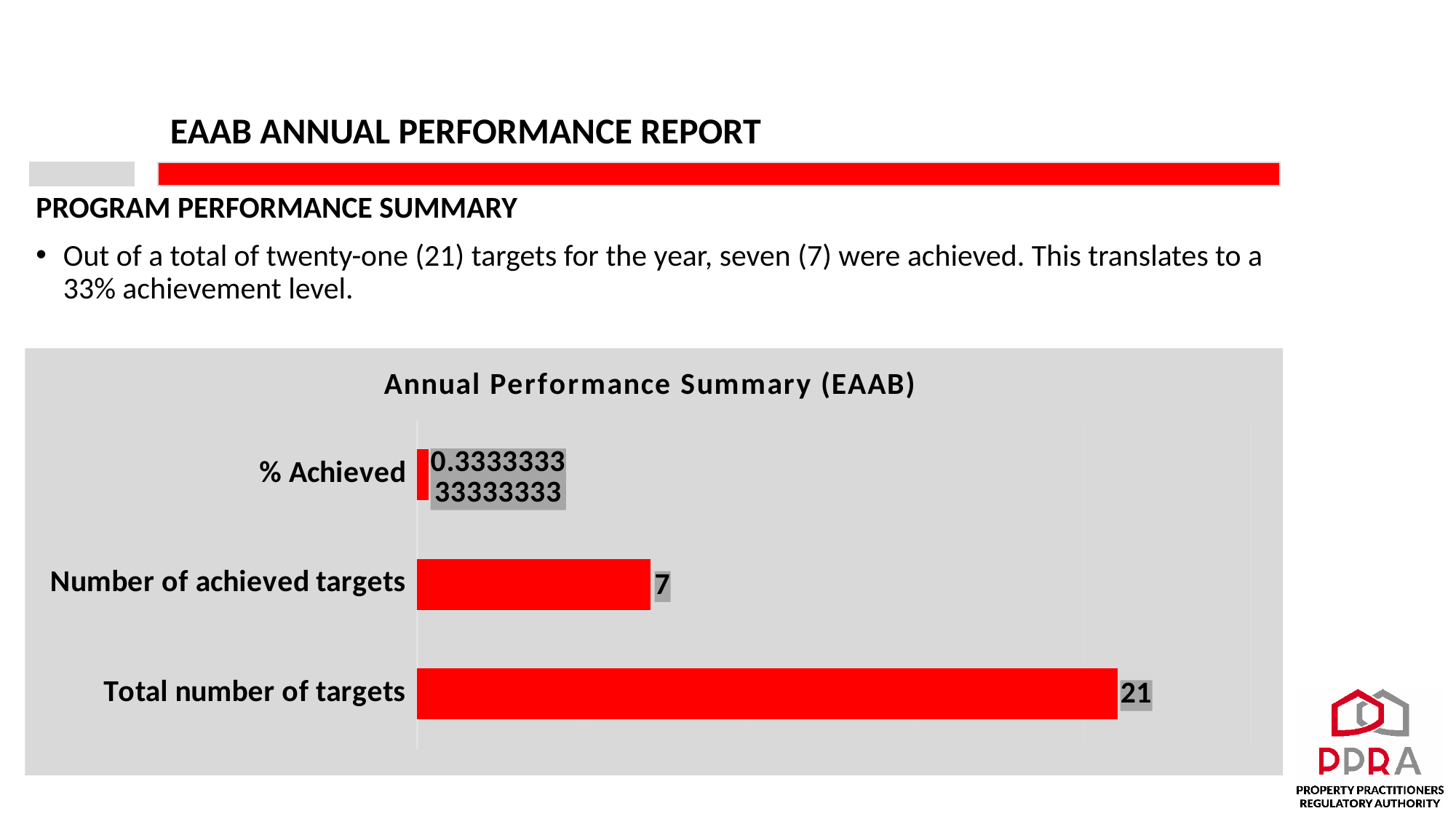
What is the value for Total number of targets? 21 Which is larger, Total number of targets or Number of achieved targets? Total number of targets How many categories are shown in the chart? 3 Which category has the lowest value? % Achieved What is the value for Number of achieved targets? 7 What type of chart is shown on the slide? bar chart What is the data label shown for % Achieved? 0.333333333333333 What is the title of the chart? Annual Performance Summary (EAAB) What colour are the bars in the chart? red What is the difference between Total number of targets and Number of achieved targets? 14 Which category has the highest value? Total number of targets